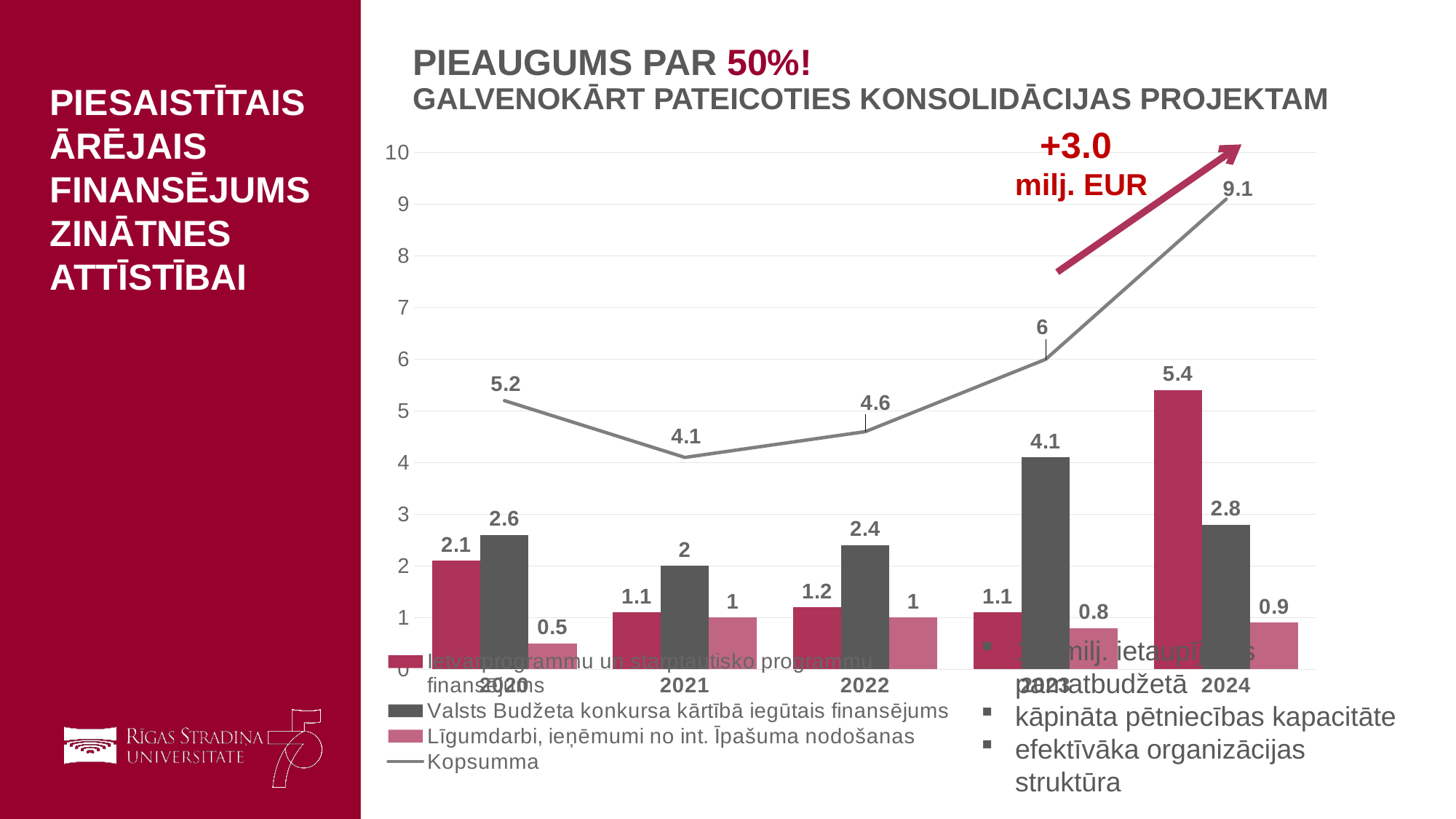
Does the Kopsumma line rise or fall from 2021 to 2024? rise What is the value of Līgumdarbi, ieņēmumi no int. Īpašuma nodošanas in 2020? 0.5 What is the value of Ietvarprogrammu un starptautisko programmu finansējums in 2024? 5.4 What is the value of Valsts Budžeta konkursa kārtībā iegūtais finansējums in 2023? 4.1 How many years are shown on the x axis? 5 In which year is the Kopsumma line at its lowest? 2021 Which series is drawn as a line rather than bars? Kopsumma How many series does the legend list? 4 Which is larger in 2022: Valsts Budžeta konkursa kārtībā iegūtais finansējums or Ietvarprogrammu un starptautisko programmu finansējums? Valsts Budžeta konkursa kārtībā iegūtais finansējums In which year is the Kopsumma line at its highest? 2024 What is the Kopsumma value for 2024? 9.1 What is the difference between the Kopsumma values for 2024 and 2023? 3.1